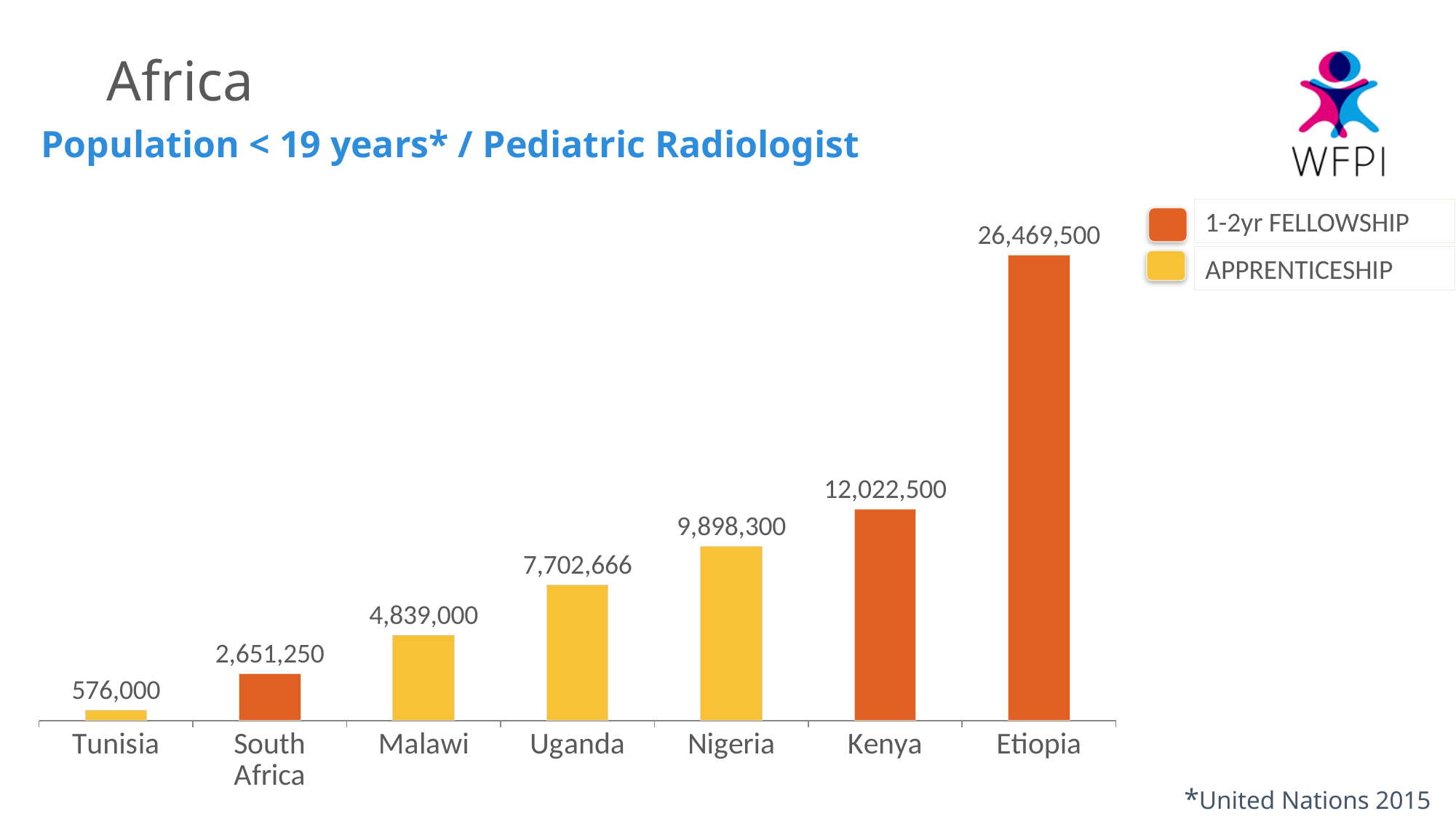
What kind of chart is shown on the slide? Bar chart Which country has the lowest value? Tunisia What is the value shown for Tunisia? 576,000 What is the value shown for Kenya? 12,022,500 Which legend category does the bar for Nigeria belong to? APPRENTICESHIP What is the difference between the values for Etiopia and Kenya? 14,447,000 How many countries are shown on the chart? 7 How many series does the legend list? 2 What is the difference between the values for Nigeria and Malawi? 5,059,300 Which country has the highest value? Etiopia Which has a larger value, South Africa or Malawi? Malawi What is the value shown for Uganda? 7,702,666